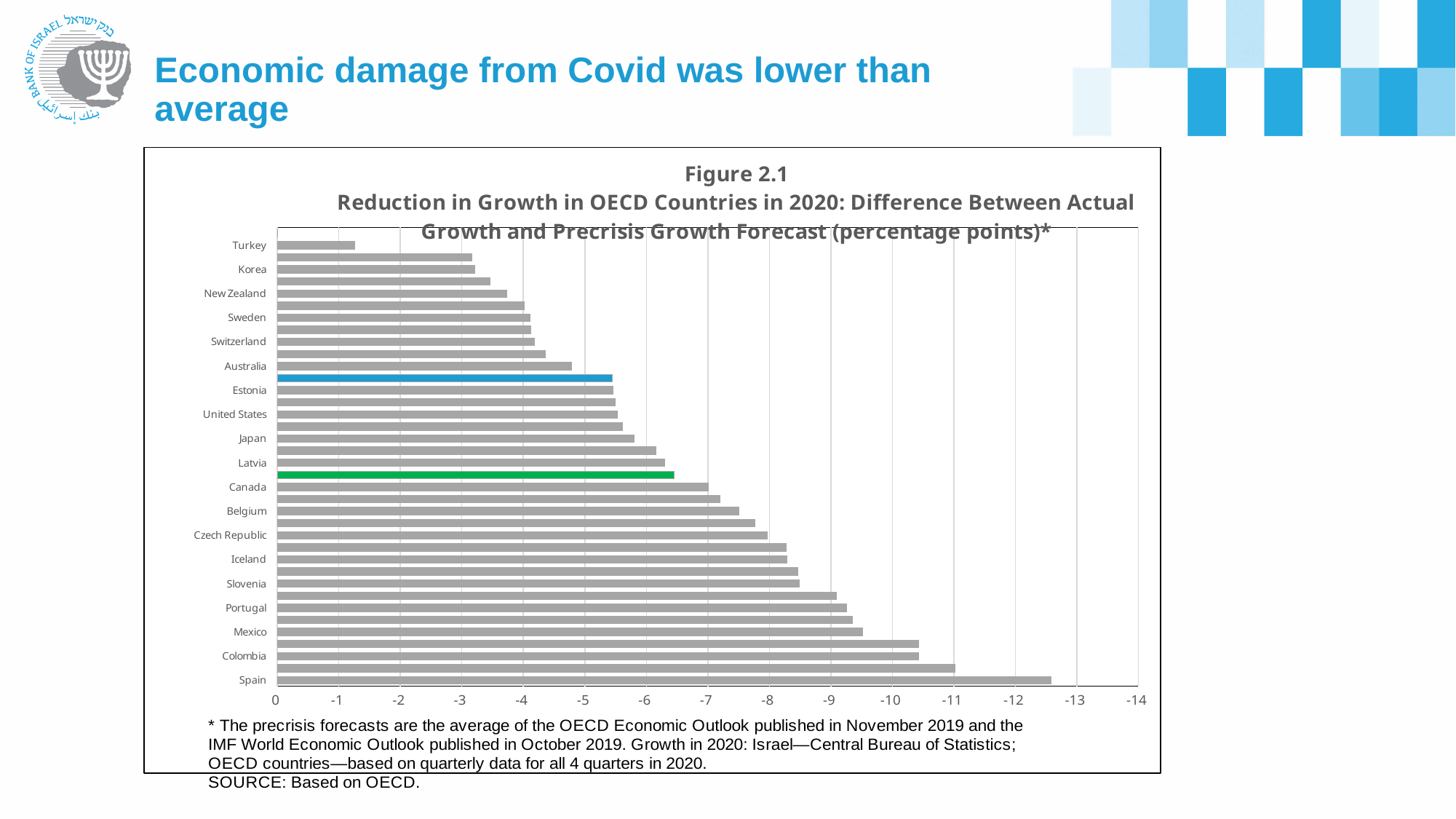
Is the value for Colombia greater or less than -10? less Is the value for Spain greater or less than -12? less Is the value for Iceland greater or less than -8? less Which country has the shortest bar (smallest reduction in growth) in Figure 2.1? Turkey Do the bars get longer or shorter moving from the top of the chart (Turkey) to the bottom (Spain)? Longer Which country shows a larger reduction in growth, Japan or Korea? Japan What kind of chart is shown in Figure 2.1? Bar chart Which country shows a larger reduction in growth, Colombia or Canada? Colombia What figure number is given in the chart title? Figure 2.1 Which country has the longest bar (largest reduction in growth) in Figure 2.1? Spain